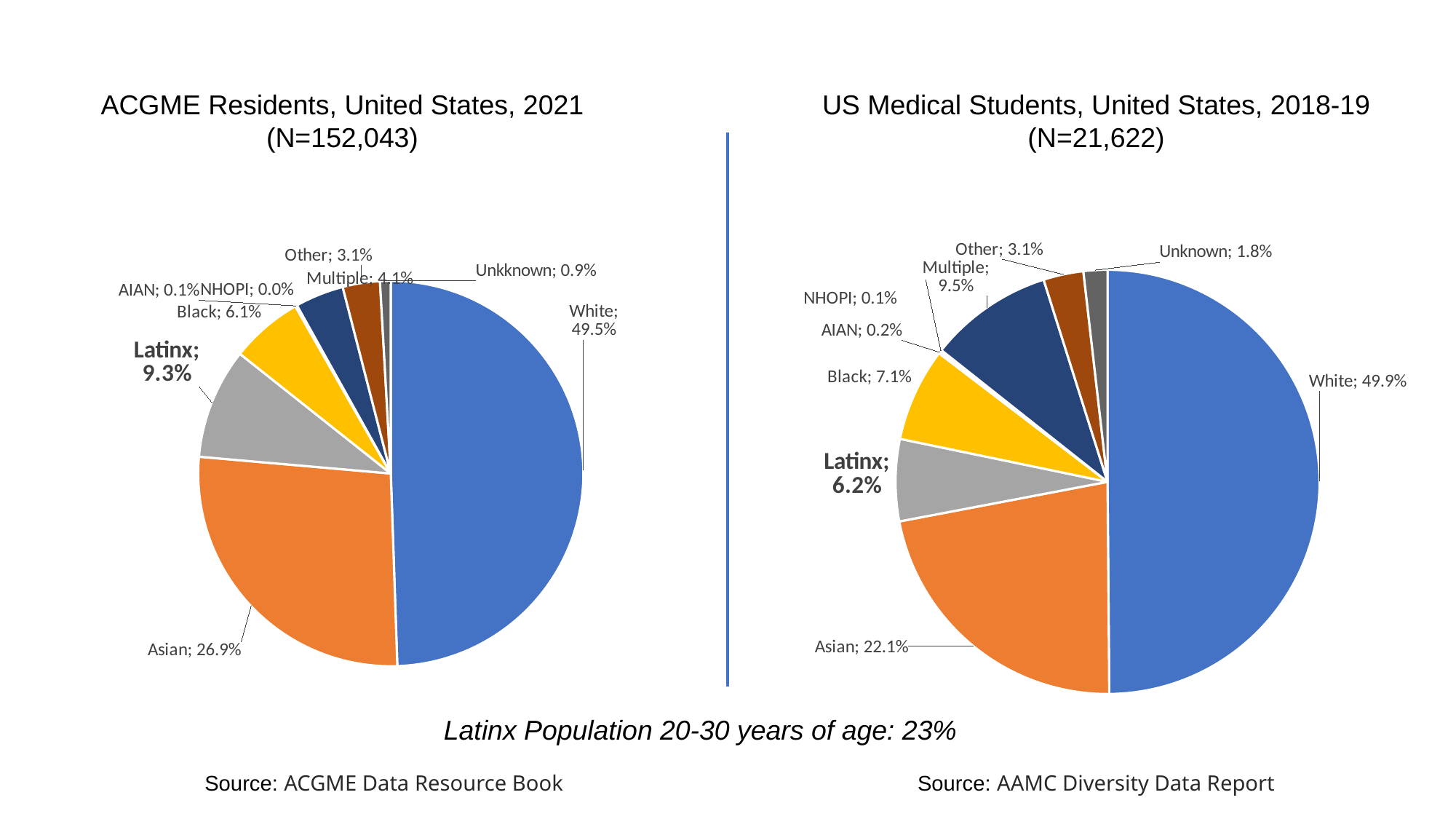
In the ACGME Residents, United States, 2021 chart, what is the difference between the White and Asian shares? 22.6% In the US Medical Students, United States, 2018-19 chart, what percentage is Latinx? 6.2% In the ACGME Residents, United States, 2021 chart, which category has the largest share? White What kind of chart is the US Medical Students, United States, 2018-19 chart? Pie chart In the US Medical Students, United States, 2018-19 chart, which category has the smallest share? NHOPI In the US Medical Students, United States, 2018-19 chart, what percentage is Multiple? 9.5% In the US Medical Students, United States, 2018-19 chart, which is larger, Black or Latinx? Black In the ACGME Residents, United States, 2021 chart, what percentage is Asian? 26.9% What is the source cited for the US Medical Students, United States, 2018-19 chart? AAMC Diversity Data Report In the ACGME Residents, United States, 2021 chart, what percentage is Latinx? 9.3% How many categories are shown in the ACGME Residents, United States, 2021 chart? 9 What is the difference between the Latinx share in the ACGME Residents, United States, 2021 chart and the Latinx share in the US Medical Students, United States, 2018-19 chart? 3.1%